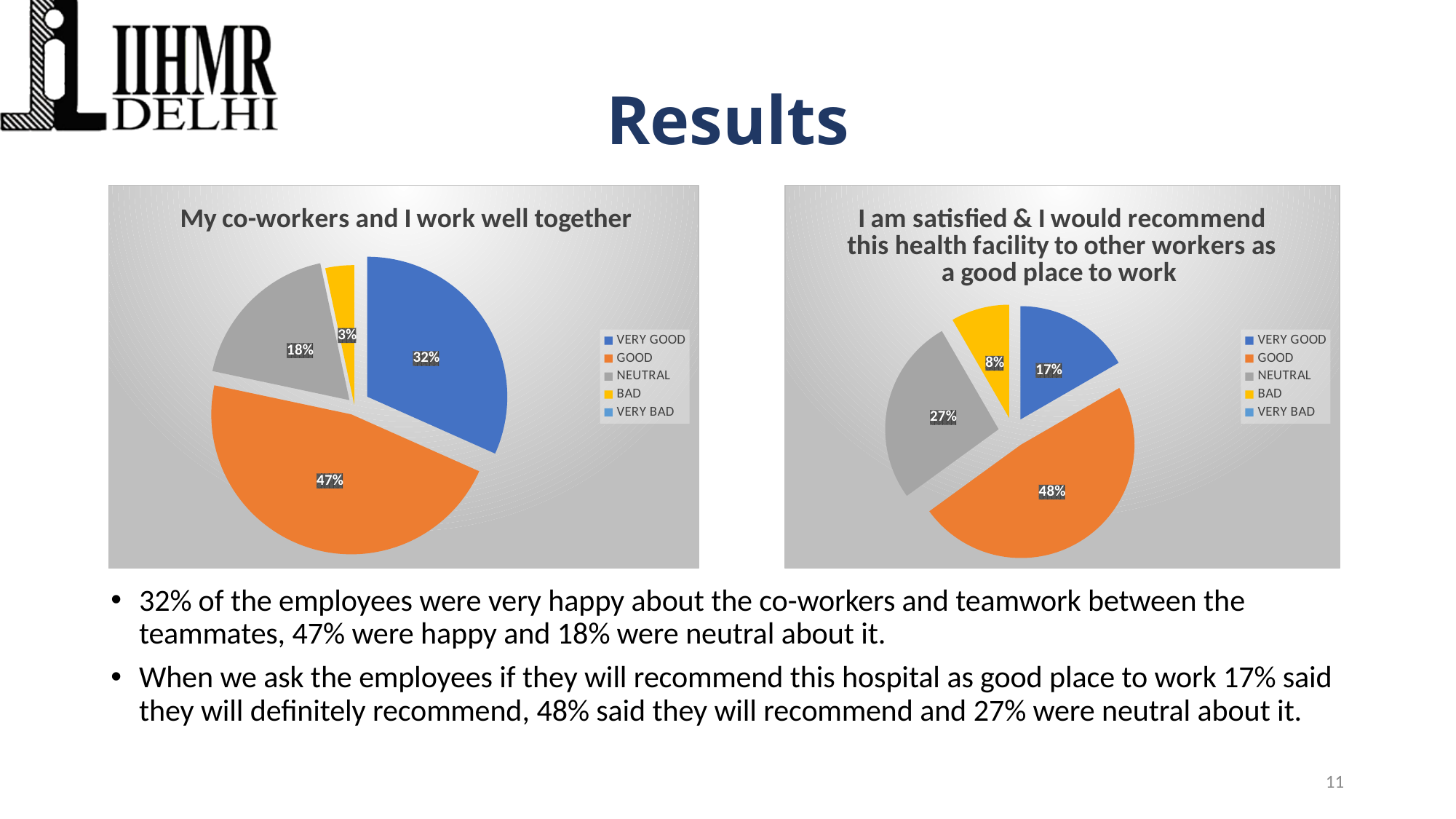
In the 'My co-workers and I work well together' chart, what is the difference between the GOOD and NEUTRAL shares? 29% In the 'I am satisfied & I would recommend this health facility to other workers as a good place to work' chart, which is larger, VERY GOOD or NEUTRAL? NEUTRAL In the 'I am satisfied & I would recommend this health facility to other workers as a good place to work' chart, what share of responses is NEUTRAL? 27% In the 'I am satisfied & I would recommend this health facility to other workers as a good place to work' chart, which category has the largest slice? GOOD In the 'My co-workers and I work well together' chart, what share of responses is VERY GOOD? 32% In the 'My co-workers and I work well together' chart, which category has the largest slice? GOOD How many entries does the legend of the 'My co-workers and I work well together' chart list? 5 In the 'My co-workers and I work well together' chart, what share of responses is BAD? 3% In the 'I am satisfied & I would recommend this health facility to other workers as a good place to work' chart, what is the difference between the GOOD and VERY GOOD shares? 31% In the 'I am satisfied & I would recommend this health facility to other workers as a good place to work' chart, what share of responses is BAD? 8% What type of chart is 'My co-workers and I work well together'? Pie chart In the 'My co-workers and I work well together' chart, what share of responses is GOOD? 47%